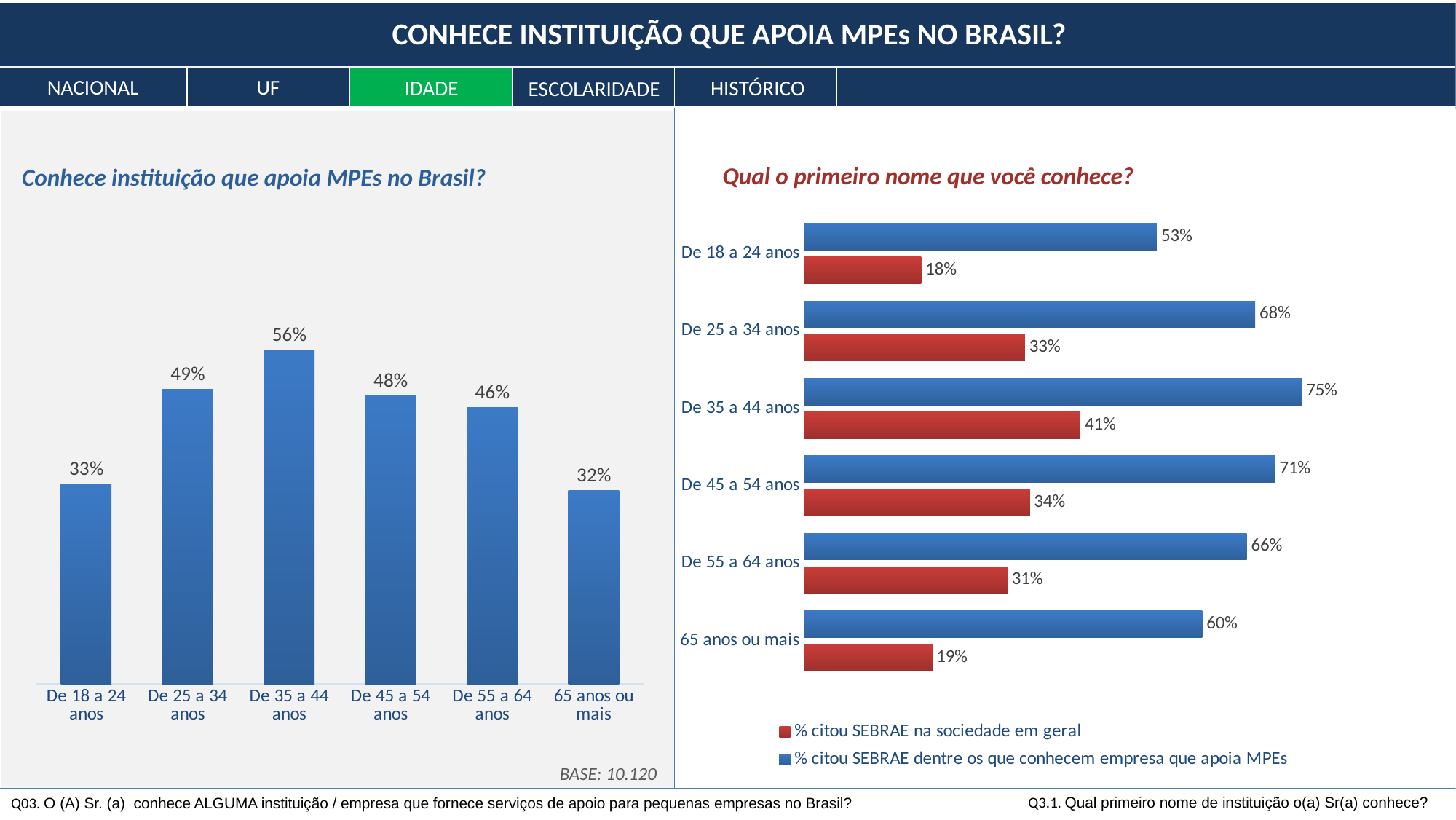
In the left chart 'Conhece instituição que apoia MPEs no Brasil?', what is the difference between De 25 a 34 anos and De 18 a 24 anos? 16% In the right chart 'Qual o primeiro nome que você conhece?', which is larger for De 45 a 54 anos: '% citou SEBRAE na sociedade em geral' or '% citou SEBRAE dentre os que conhecem empresa que apoia MPEs'? % citou SEBRAE dentre os que conhecem empresa que apoia MPEs In the left chart 'Conhece instituição que apoia MPEs no Brasil?', which age group has the highest value? De 35 a 44 anos In the right chart 'Qual o primeiro nome que você conhece?', which age group has the highest value for '% citou SEBRAE dentre os que conhecem empresa que apoia MPEs'? De 35 a 44 anos In the right chart 'Qual o primeiro nome que você conhece?', what is the value of '% citou SEBRAE dentre os que conhecem empresa que apoia MPEs' for 65 anos ou mais? 60% In the right chart 'Qual o primeiro nome que você conhece?', what is the value of '% citou SEBRAE na sociedade em geral' for De 35 a 44 anos? 41% In the left chart 'Conhece instituição que apoia MPEs no Brasil?', what is the value for De 35 a 44 anos? 56% In the left chart 'Conhece instituição que apoia MPEs no Brasil?', which age group has the lowest value? 65 anos ou mais In the left chart 'Conhece instituição que apoia MPEs no Brasil?', how many age groups are shown? 6 In the right chart 'Qual o primeiro nome que você conhece?', which age group has the lowest value for '% citou SEBRAE na sociedade em geral'? De 18 a 24 anos What kind of chart is the left chart 'Conhece instituição que apoia MPEs no Brasil?'? Bar chart In the right chart 'Qual o primeiro nome que você conhece?', how many series does the legend list? 2